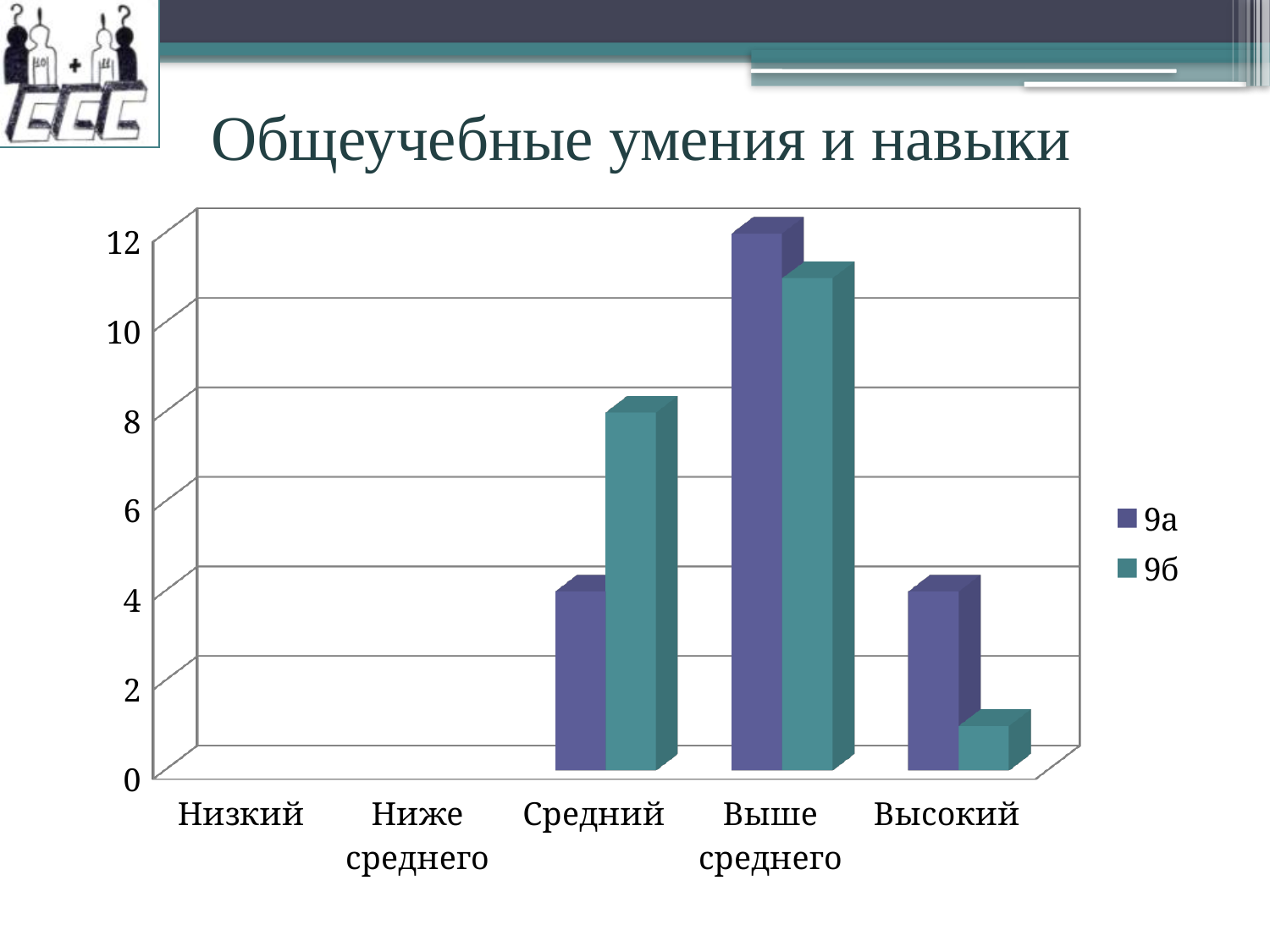
What is the value for 9б in the category Средний? 8 In the category Высокий, which series has the larger value, 9а or 9б? 9а What is the value for 9а in the category Выше среднего? 12 How many categories are shown on the x axis? 5 Is the value for 9б in the category Выше среднего greater or less than 10? greater What kind of chart is shown on the slide? bar chart What is the title of the chart on the slide? Общеучебные умения и навыки How many series does the legend list? 2 Is the value for 9б in the category Высокий greater or less than 2? less Which category has the highest value for series 9а? Выше среднего In the category Средний, which series has the larger value, 9а or 9б? 9б Which category has the highest value for series 9б? Выше среднего